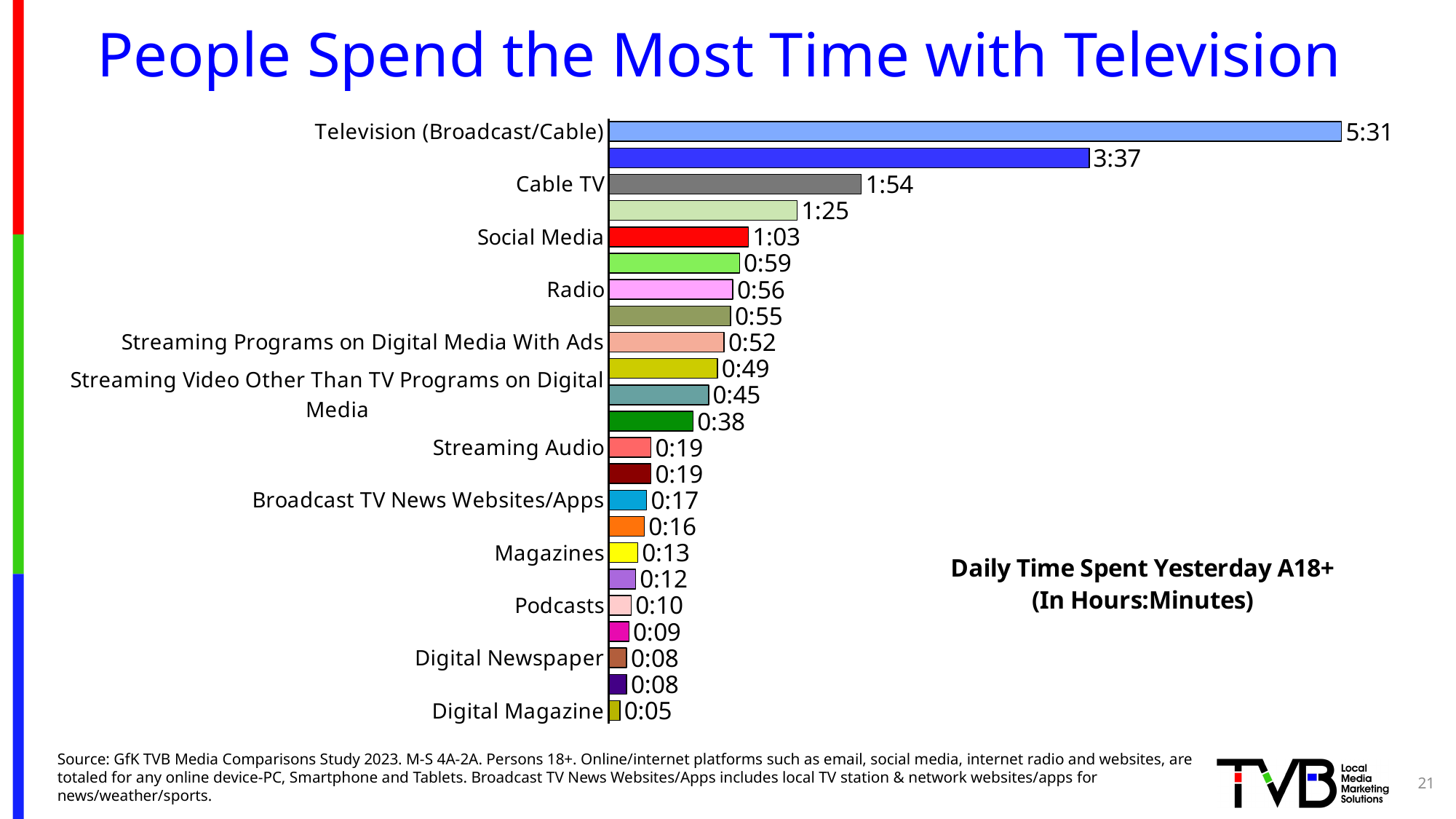
What is the difference in daily time spent between Social Media and Radio? 0:07 Which category has the highest daily time spent? Television (Broadcast/Cable) What is the daily time spent with Cable TV? 1:54 What is the daily time spent with Social Media? 1:03 Which has a higher daily time spent, Magazines or Podcasts? Magazines How many bars are plotted in the chart? 23 What is the daily time spent with Radio? 0:56 What is the daily time spent with Television (Broadcast/Cable)? 5:31 What is the daily time spent with Digital Magazine? 0:05 What type of chart is shown on the slide? Bar chart What is the daily time spent with Streaming Audio? 0:19 Which category has the lowest daily time spent? Digital Magazine